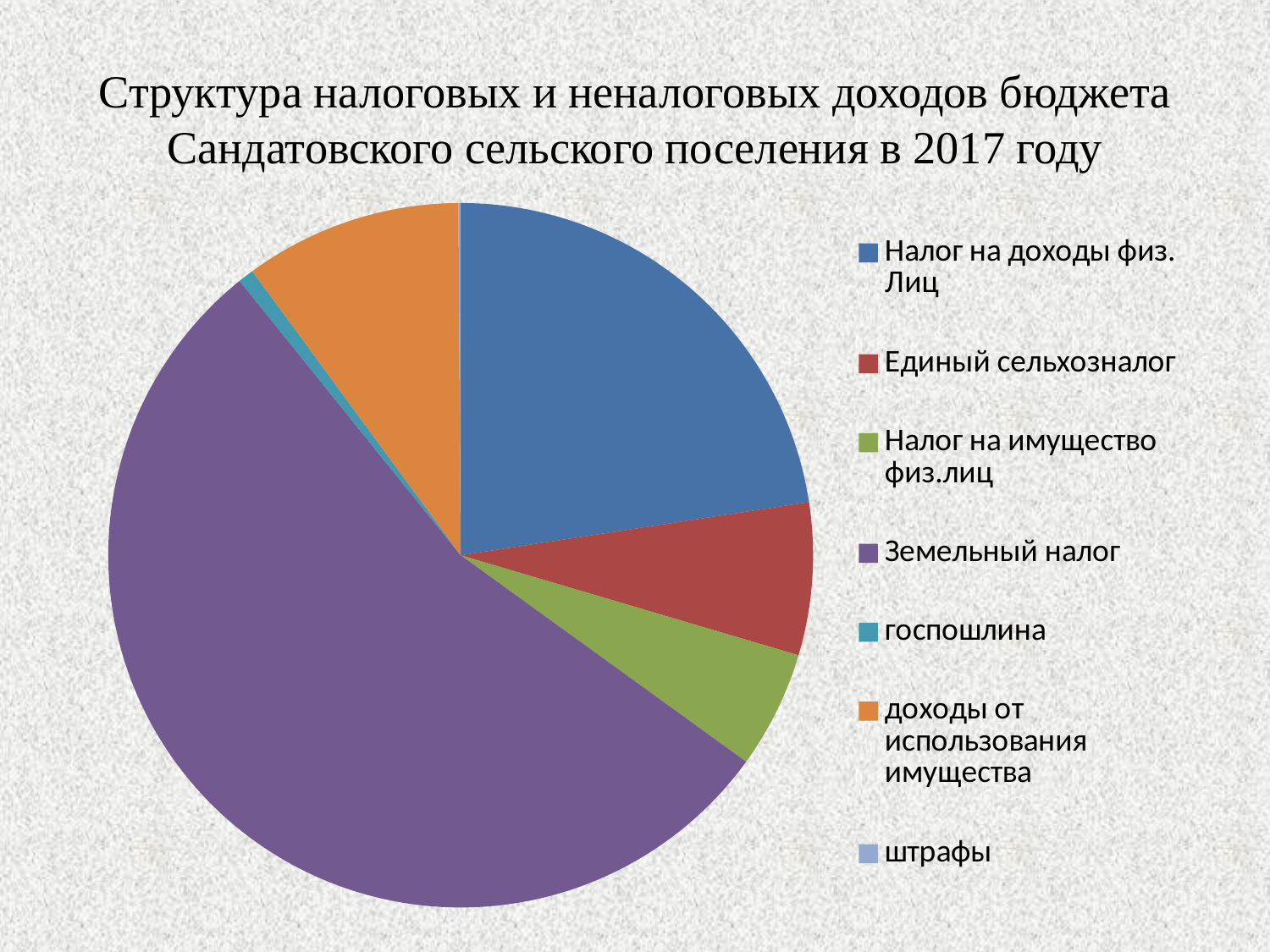
Which slice is larger: Земельный налог or доходы от использования имущества? Земельный налог How many categories does the legend of the pie chart list? 7 What colour is the slice for Земельный налог? purple Which category has the largest slice of the pie? Земельный налог Is the share of Налог на доходы физ. Лиц greater or less than 50% of the pie? less Which slice is larger: доходы от использования имущества or Налог на имущество физ.лиц? доходы от использования имущества Is the share of Земельный налог greater or less than 50% of the pie? greater What is the title of the chart on the slide? Структура налоговых и неналоговых доходов бюджета Сандатовского сельского поселения в 2017 году Which slice is larger: госпошлина or Единый сельхозналог? Единый сельхозналог What kind of chart is shown on the slide? pie chart